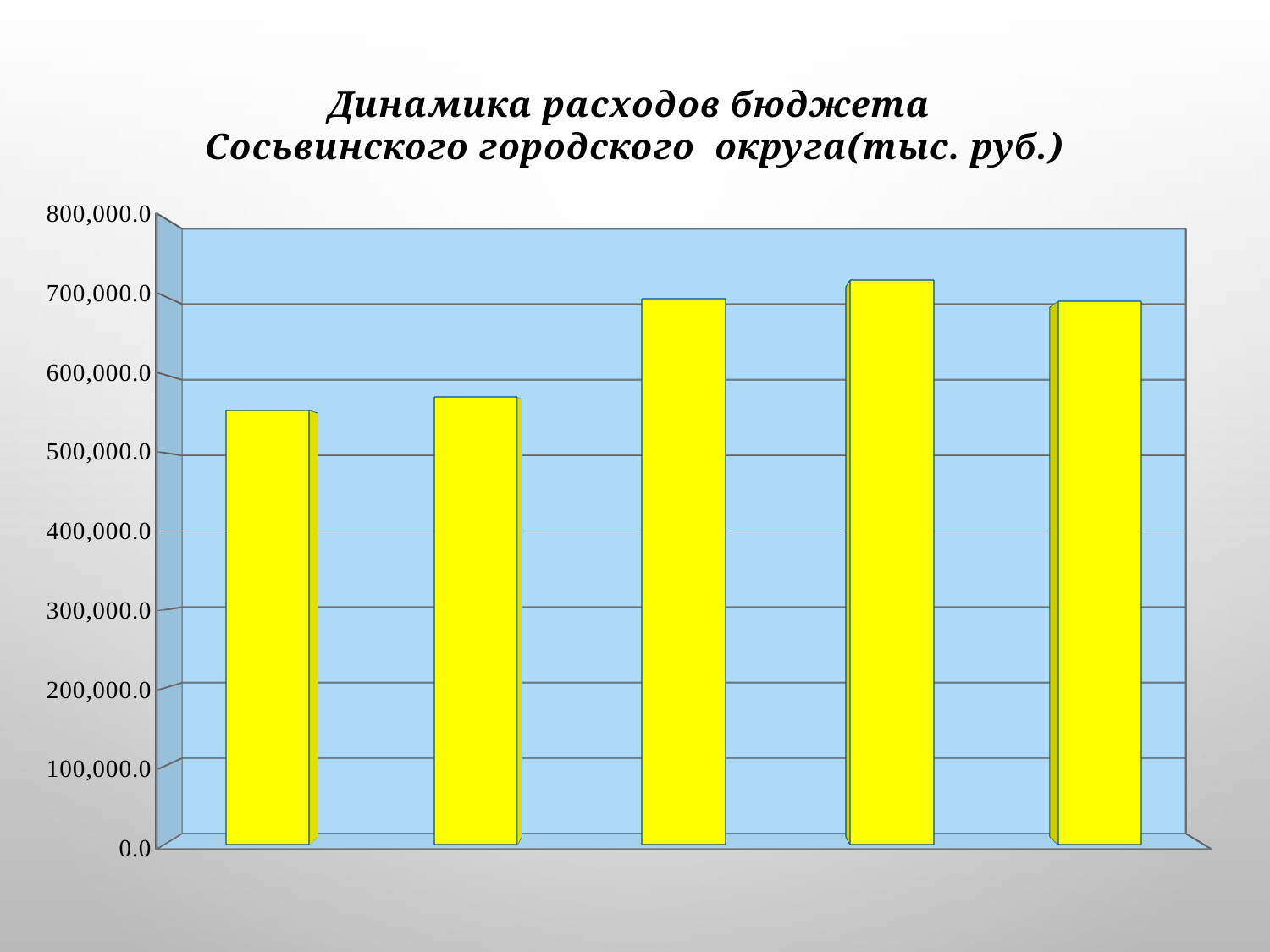
What colour are the bars in the chart? yellow Which bar is the shortest in the chart? the leftmost bar What kind of chart is shown on the slide? bar chart How many bars are plotted in the chart? 5 Is the value of the leftmost bar greater or less than 500,000.0? greater Is the value of the fourth bar from the left greater or less than 700,000.0? greater Is the value of the second bar from the left greater or less than 600,000.0? less Which bar is the tallest in the chart? the fourth bar from the left What is the title of the chart? Динамика расходов бюджета Сосьвинского городского округа(тыс. руб.)